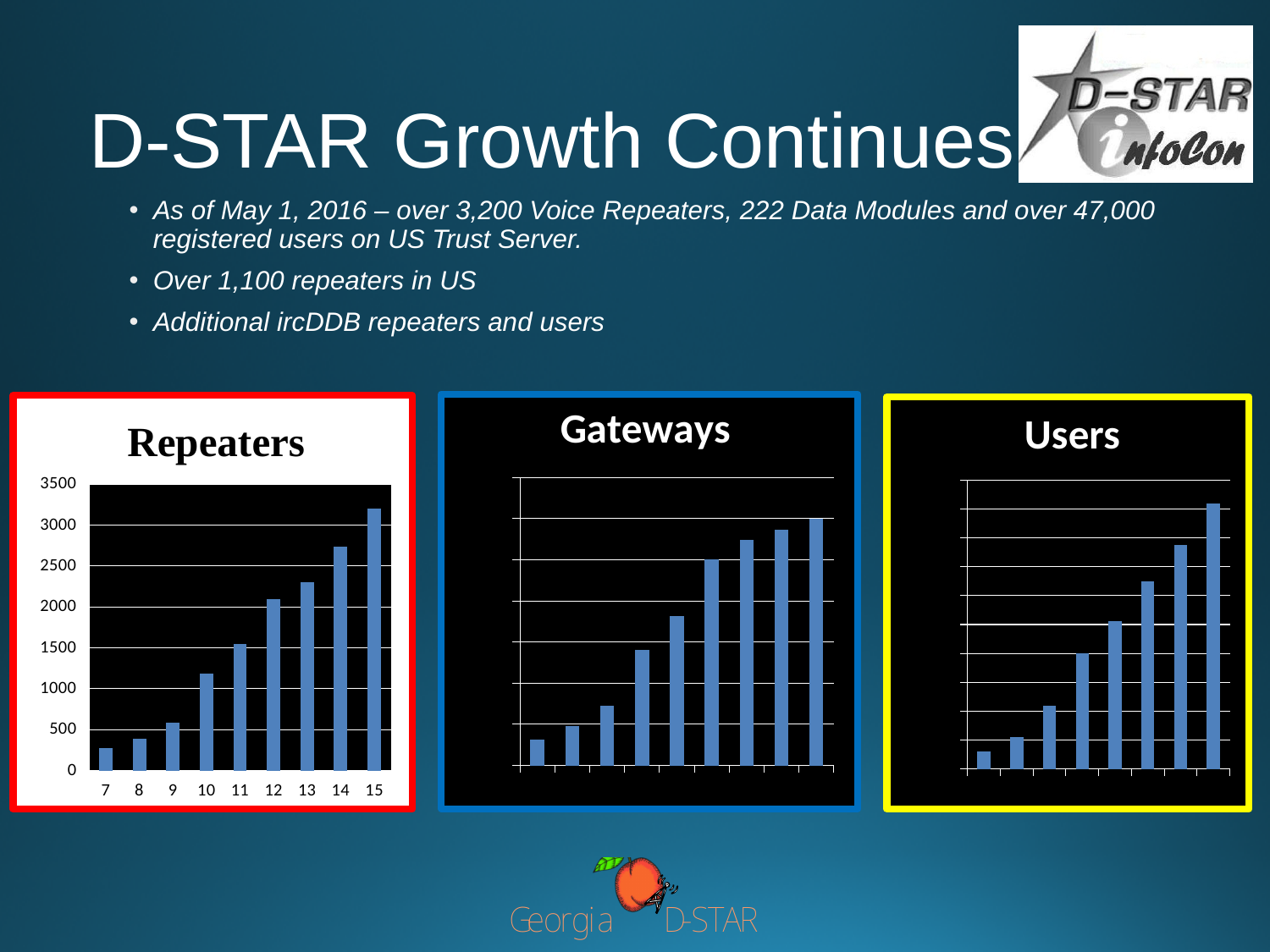
In the Repeaters chart, which is larger, the value for category 11 or the value for category 13? 13 What kind of chart is the Repeaters chart? bar chart In the Repeaters chart, is the value for category 15 greater or less than 3000? greater In the Repeaters chart, is the value for category 9 greater or less than 1000? less In the Repeaters chart, which category has the highest value? 15 In the Repeaters chart, is the value for category 10 greater or less than 1000? greater In the Repeaters chart, do the values rise or fall from category 7 to category 15? rise In the Repeaters chart, which category has the lowest value? 7 In the Users chart, do the bars rise or fall from left to right? rise In the Gateways chart, how many bars are plotted? 9 In the Repeaters chart, how many bars are plotted? 9